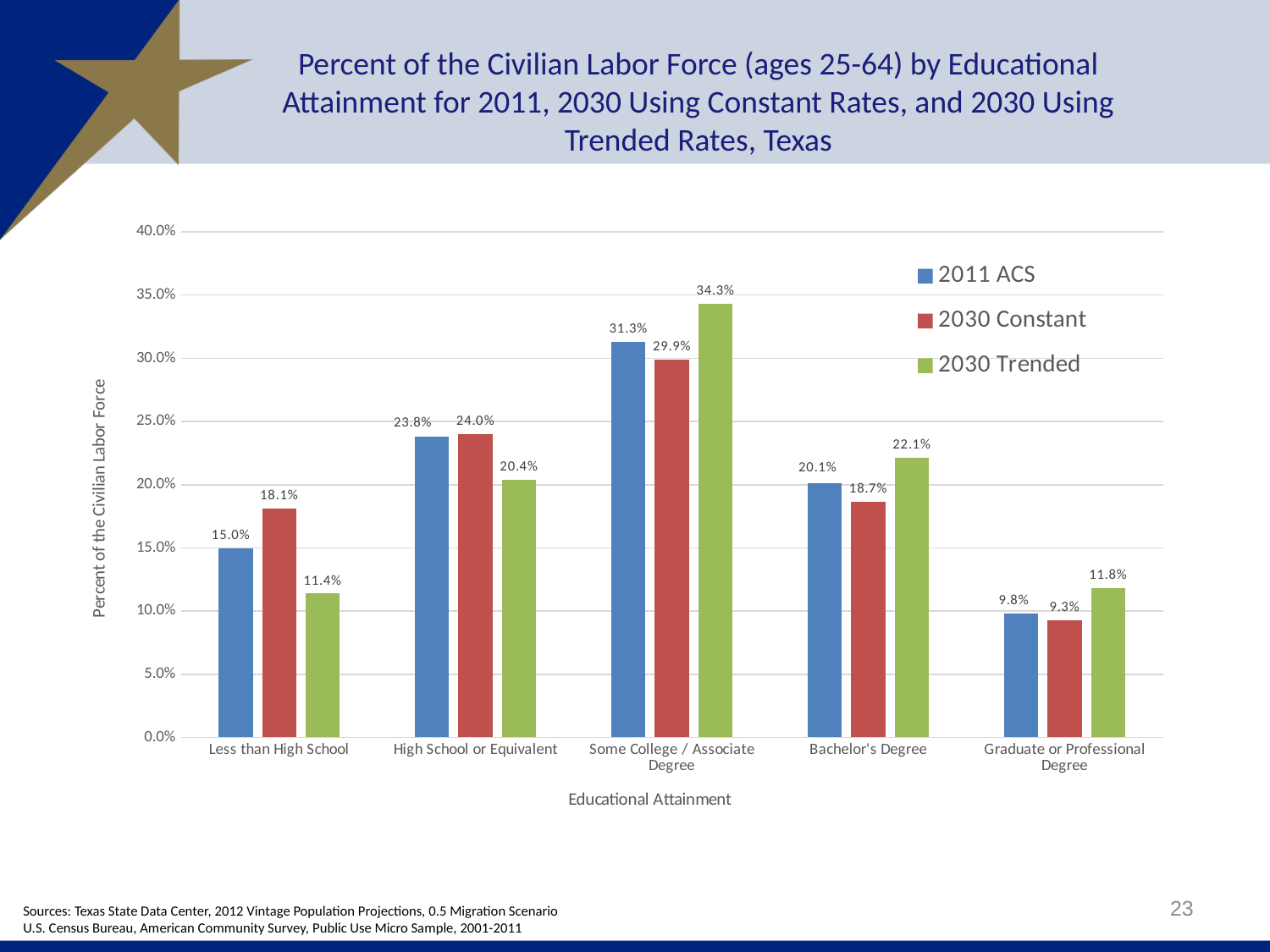
What is the 2030 Trended value for Some College / Associate Degree? 34.3% Which is larger for High School or Equivalent: the 2011 ACS value or the 2030 Trended value? 2011 ACS What kind of chart is shown on the slide? Bar chart Which series is shown in green in the legend? 2030 Trended Which educational attainment category has the highest 2030 Trended value? Some College / Associate Degree What is the 2011 ACS value for Less than High School? 15.0% What is the difference between the 2030 Trended and 2011 ACS values for Bachelor's Degree? 2.0% How many educational attainment categories are shown on the x axis? 5 What is the label of the y axis? Percent of the Civilian Labor Force How many series does the legend list? 3 Which educational attainment category has the lowest 2011 ACS value? Graduate or Professional Degree What is the 2030 Constant value for Bachelor's Degree? 18.7%